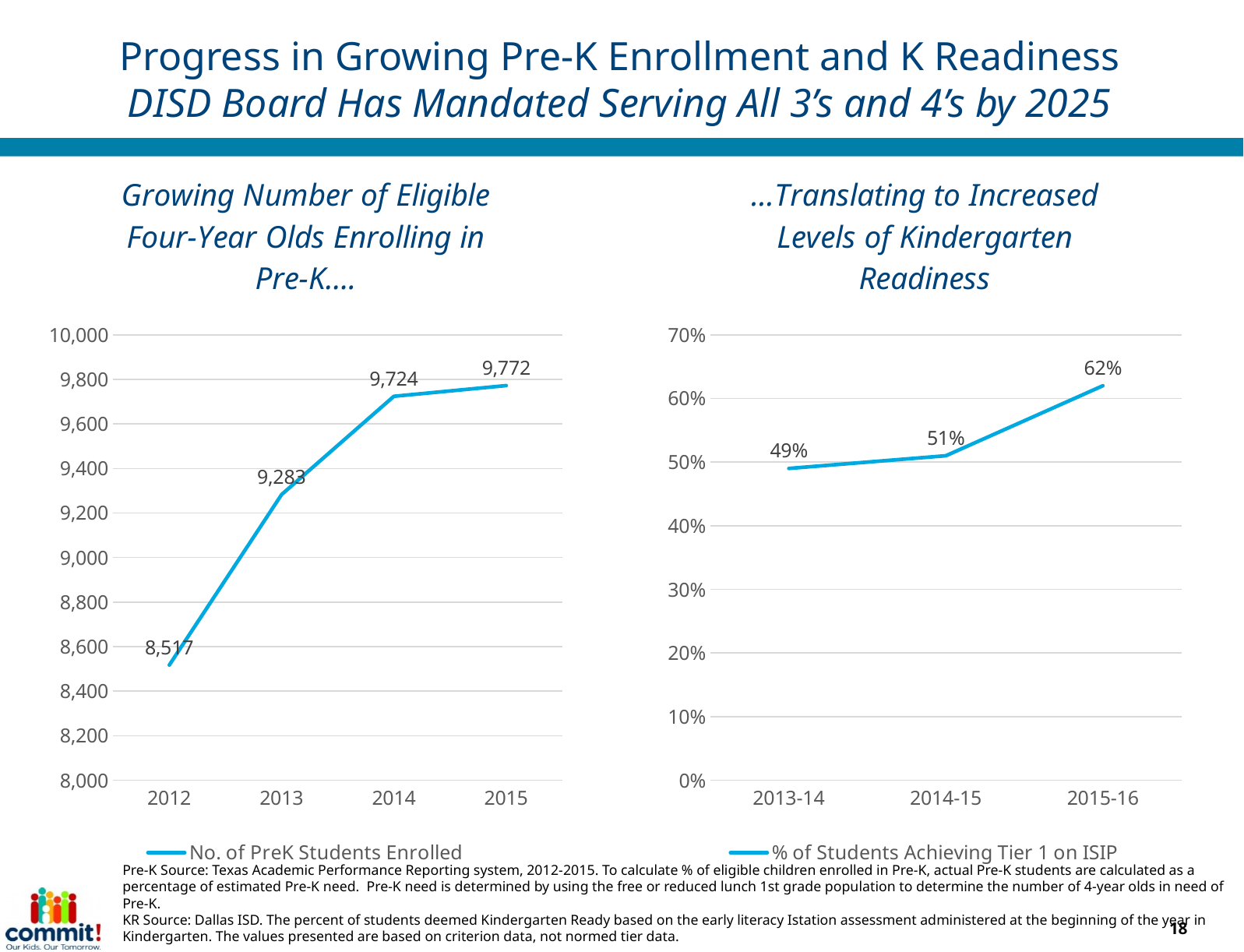
In the left chart (Growing Number of Eligible Four-Year Olds Enrolling in Pre-K), how many years are plotted? 4 What is the legend entry for the series in the left chart (Growing Number of Eligible Four-Year Olds Enrolling in Pre-K)? No. of PreK Students Enrolled In the right chart (Translating to Increased Levels of Kindergarten Readiness), what percent of students achieved Tier 1 on ISIP in 2014-15? 51% In the right chart (Translating to Increased Levels of Kindergarten Readiness), which school year had the lowest percent of students achieving Tier 1 on ISIP? 2013-14 What kind of chart is the right chart (Translating to Increased Levels of Kindergarten Readiness)? line chart In the right chart (Translating to Increased Levels of Kindergarten Readiness), what is the difference between the 2015-16 and 2013-14 values? 13% In the left chart (Growing Number of Eligible Four-Year Olds Enrolling in Pre-K), what is the difference in enrollment between 2015 and 2012? 1,255 In the left chart (Growing Number of Eligible Four-Year Olds Enrolling in Pre-K), what was the number of PreK students enrolled in 2012? 8,517 In the left chart (Growing Number of Eligible Four-Year Olds Enrolling in Pre-K), does enrollment rise or fall from 2012 to 2015? rise In the left chart (Growing Number of Eligible Four-Year Olds Enrolling in Pre-K), what was the number of PreK students enrolled in 2013? 9,283 In the right chart (Translating to Increased Levels of Kindergarten Readiness), is the value for 2015-16 greater or less than 60%? greater In the left chart (Growing Number of Eligible Four-Year Olds Enrolling in Pre-K), which year had the highest enrollment? 2015